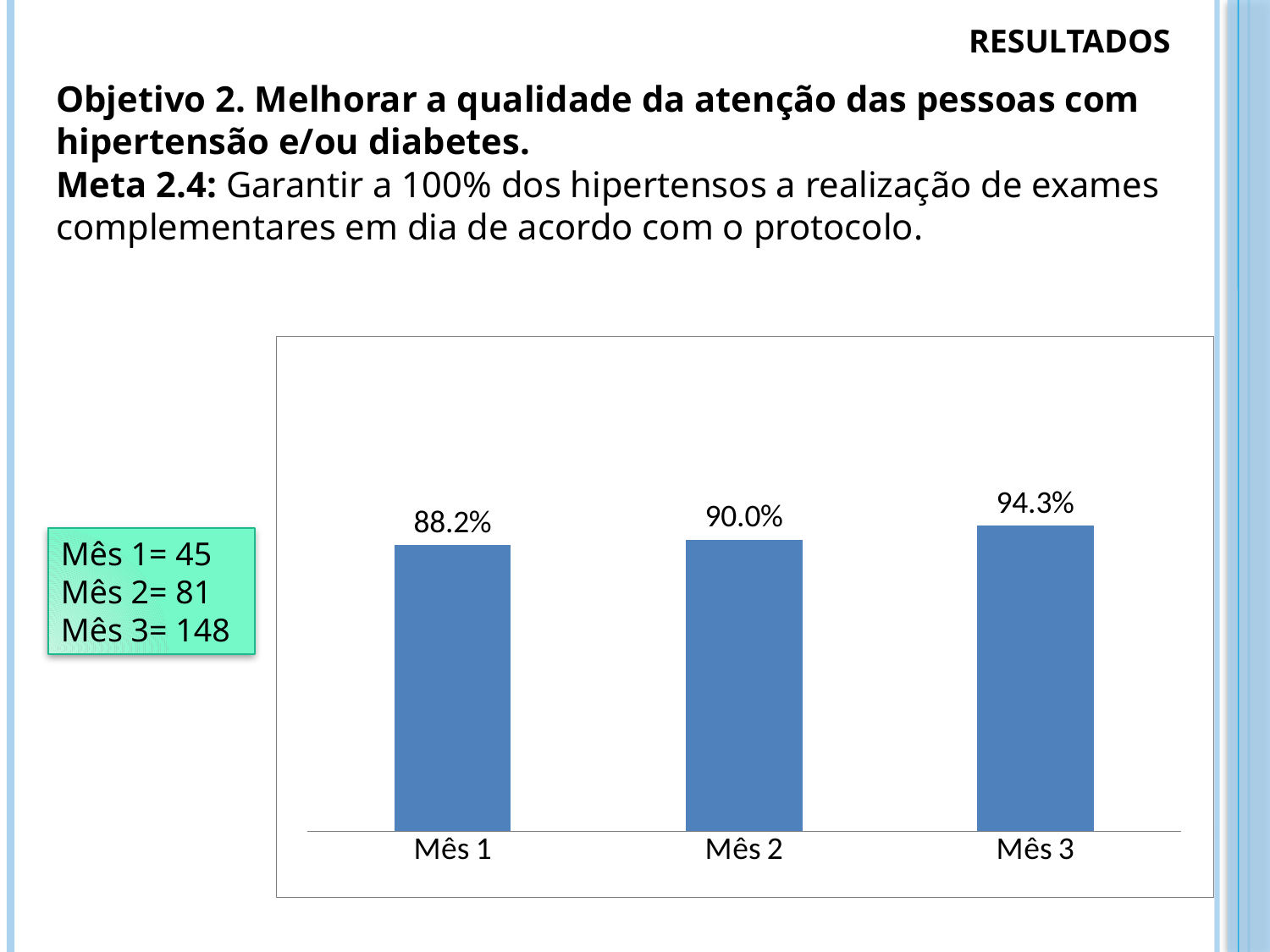
What colour are the bars in the chart? Blue Which month has the highest value? Mês 3 How many categories are shown on the x axis? 3 What is the value for Mês 3? 94.3% What is the value for Mês 1? 88.2% What kind of chart is shown on the slide? Bar chart What is the value for Mês 2? 90.0% What is the difference between the values for Mês 2 and Mês 1? 1.8% Which is larger, the value for Mês 2 or the value for Mês 3? Mês 3 Do the values rise or fall from Mês 1 to Mês 3? Rise Which month has the lowest value? Mês 1 What is the difference between the values for Mês 3 and Mês 1? 6.1%